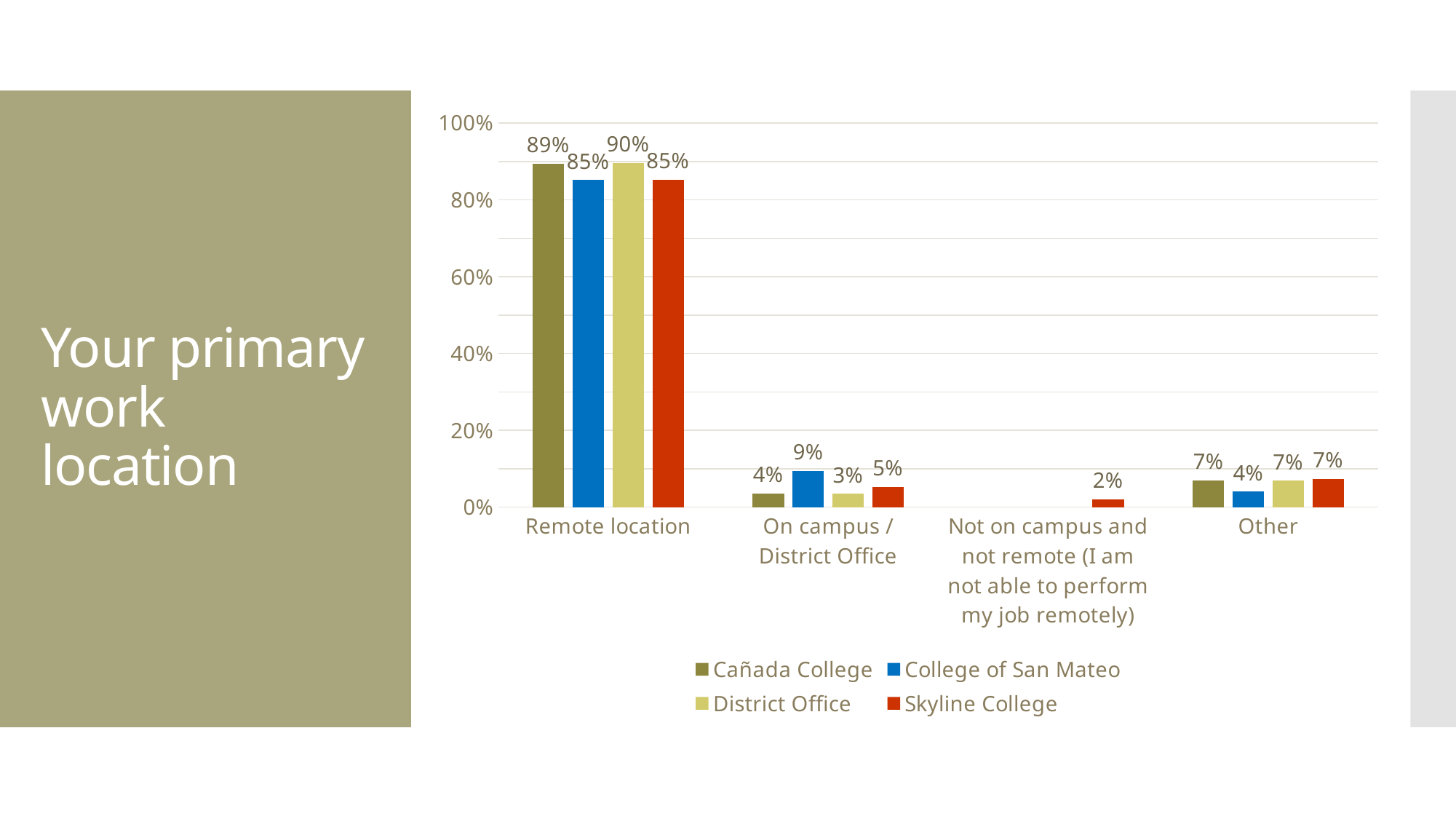
What percentage of Cañada College respondents reported a remote location as their primary work location? 89% Which series is shown in blue in the legend? College of San Mateo In the Other category, which is larger: the value for Cañada College or the value for College of San Mateo? Cañada College How many series does the legend list? 4 What is the value for District Office in the Remote location category? 90% What is the value for College of San Mateo in the On campus / District Office category? 9% How many categories are shown on the x axis? 4 What is the difference between the Remote location values for District Office and College of San Mateo? 5% What kind of chart is shown on the slide? Bar chart Which series has the highest value in the Remote location category? District Office Which series has the lowest value in the On campus / District Office category? District Office What is the value for Skyline College in the 'Not on campus and not remote' category? 2%